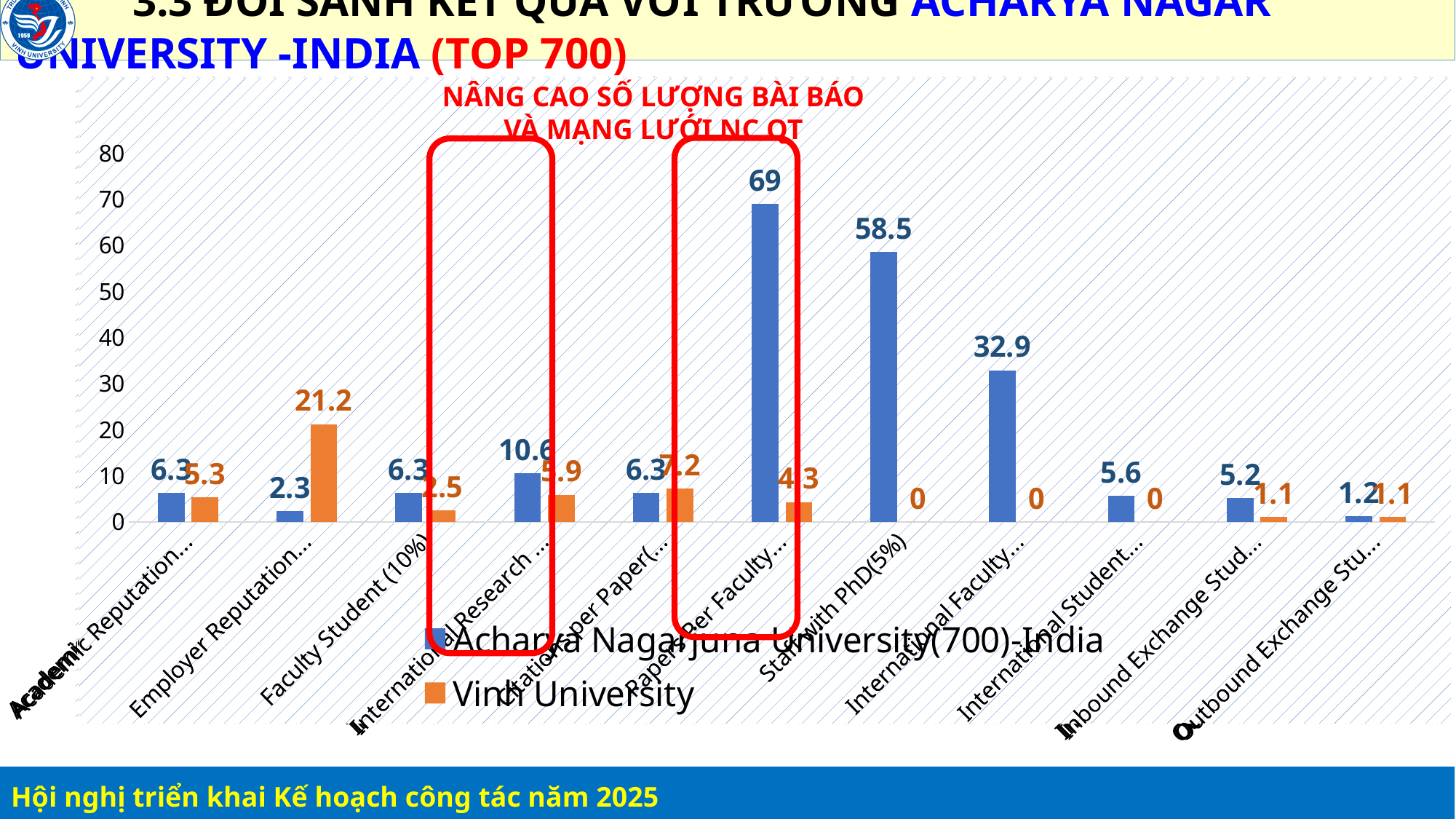
Which series is shown in orange in the legend? Vinh University What is the value for Vinh University in the Employer Reputation category? 21.2 What is the value for Acharya Nagarjuna University (700)-India in the Staff with PhD(5%) category? 58.5 Which university has the larger value in the Employer Reputation category? Vinh University In which category does Vinh University have its highest value? Employer Reputation What type of chart is shown on the slide? bar chart What is the value for Vinh University in the Faculty Student (10%) category? 2.5 How many series does the legend list? 2 What is the value for Vinh University in the Staff with PhD(5%) category? 0 How many categories are plotted along the x axis? 11 What is the difference between the two universities' values in the Papers Per Faculty category? 64.7 In which category does Acharya Nagarjuna University (700)-India have its highest value? Papers Per Faculty